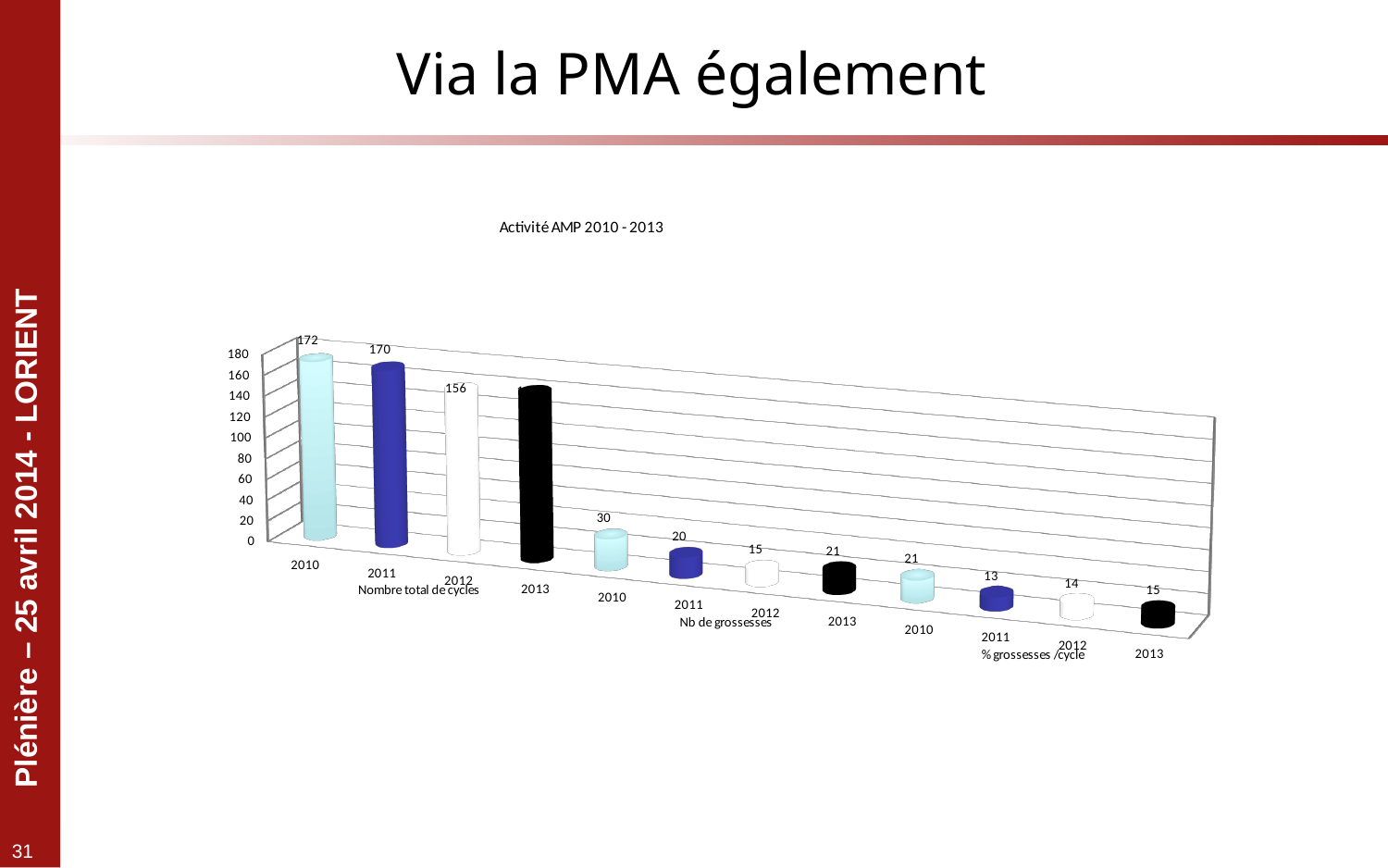
How many bars are plotted in the chart? 12 Which year has the lowest value for Nb de grossesses? 2012 What type of chart is shown on the slide? bar chart What is the value for Nb de grossesses in 2010? 30 What is the title of the chart? Activité AMP 2010 - 2013 What is the value for Nombre total de cycles in 2012? 156 What is the value for Nombre total de cycles in 2010? 172 Which year has the highest value for Nb de grossesses? 2010 Is the value for Nombre total de cycles in 2013 greater or less than 100? greater What is the value for % grossesses /cycle in 2011? 13 Which is larger: Nb de grossesses in 2013 or Nb de grossesses in 2011? 2013 What is the difference between Nombre total de cycles in 2010 and in 2012? 16